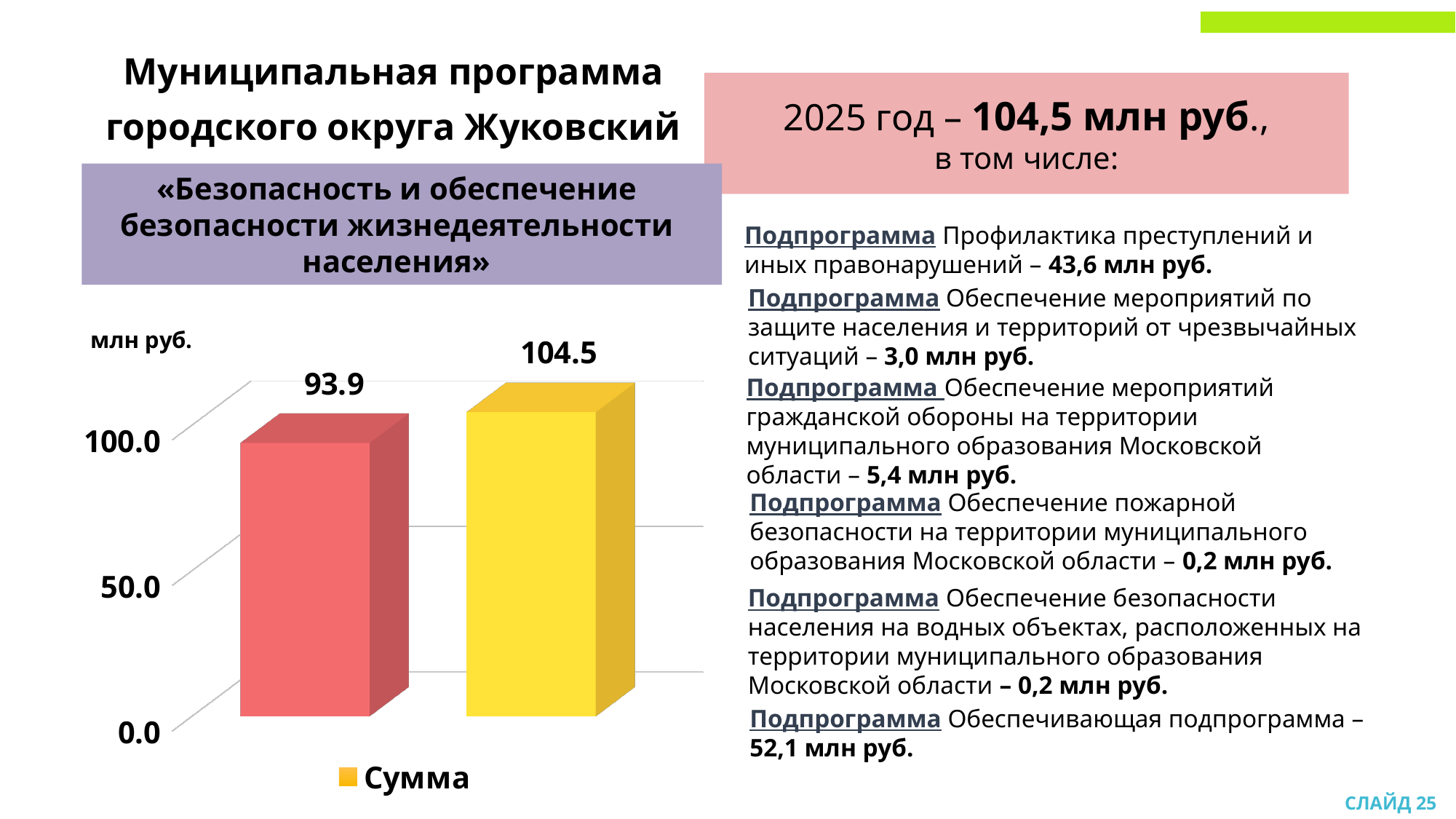
How many series does the chart legend list? 1 What is the difference between the yellow (right) bar and the red (left) bar? 10.6 What kind of chart is shown on the slide? bar chart Which bar has the highest value, the red (left) or the yellow (right) one? the yellow (right) bar What value is shown on the yellow (right) bar of the chart? 104.5 Which bar has the lowest value, the red (left) or the yellow (right) one? the red (left) bar How many bars are plotted in the chart? 2 What value is shown on the red (left) bar of the chart? 93.9 Is the value of the red (left) bar greater or less than 100.0? less Is the value of the red (left) bar larger or smaller than the value of the yellow (right) bar? smaller Do the values rise or fall from the left bar to the right bar? rise What is the name of the series in the chart legend? Сумма